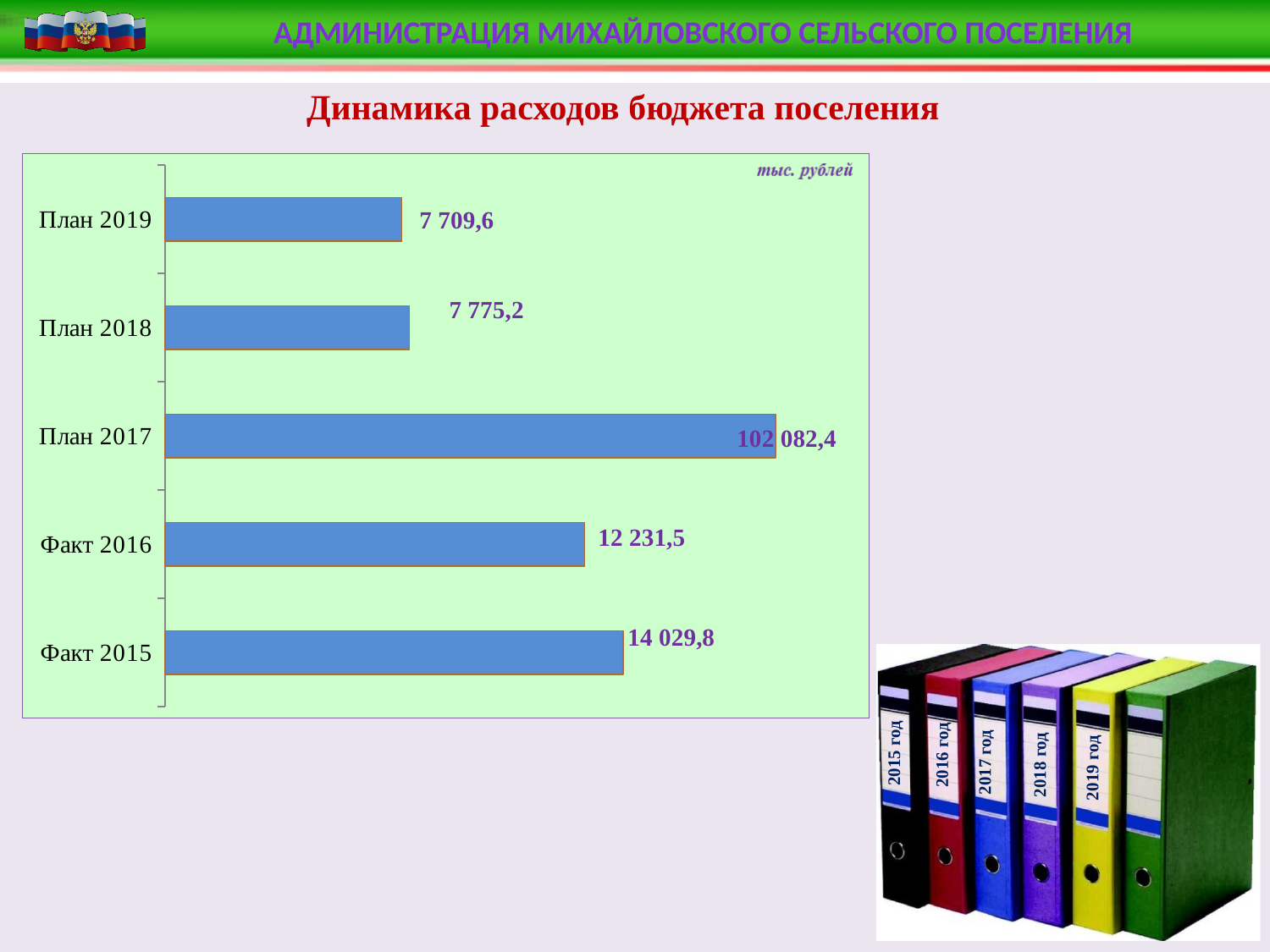
Which is larger, the value for Факт 2015 or the value for Факт 2016? Факт 2015 Which category has the highest value? План 2017 What is the difference between the values for Факт 2015 and Факт 2016? 1 798,3 What kind of chart is shown on the slide? Bar chart What unit of measurement is indicated on the chart? тыс. рублей Which category has the lowest value? План 2019 What is the value for План 2019? 7 709,6 What is the value for План 2018? 7 775,2 What is the value for Факт 2016? 12 231,5 What is the difference between the values for План 2018 and План 2019? 65,6 What is the value for Факт 2015? 14 029,8 How many categories are shown in the chart? 5